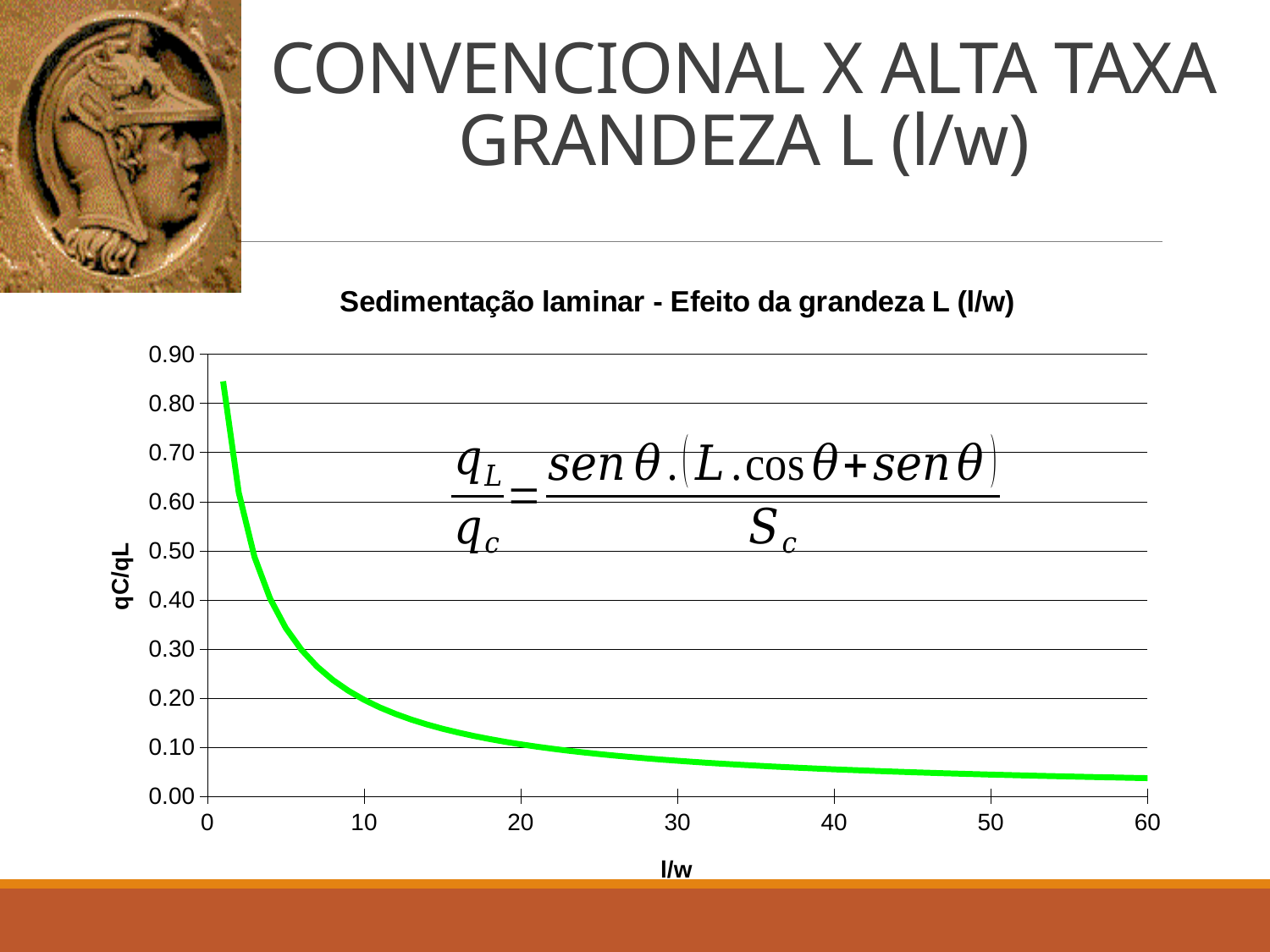
What kind of chart is shown on the slide? line chart Does the plotted value rise or fall as l/w increases along the x axis? fall Is the value of qC/qL at l/w = 5 greater or less than 0.20? greater Is the value of qC/qL at l/w = 30 greater or less than 0.10? less Which has the larger qC/qL value: l/w = 10 or l/w = 40? l/w = 10 What is the label of the vertical axis of the chart? qC/qL What is the title of the chart? Sedimentação laminar - Efeito da grandeza L (l/w) Is the value of qC/qL at l/w = 50 greater or less than 0.10? less Which has the larger qC/qL value: l/w = 2 or l/w = 20? l/w = 2